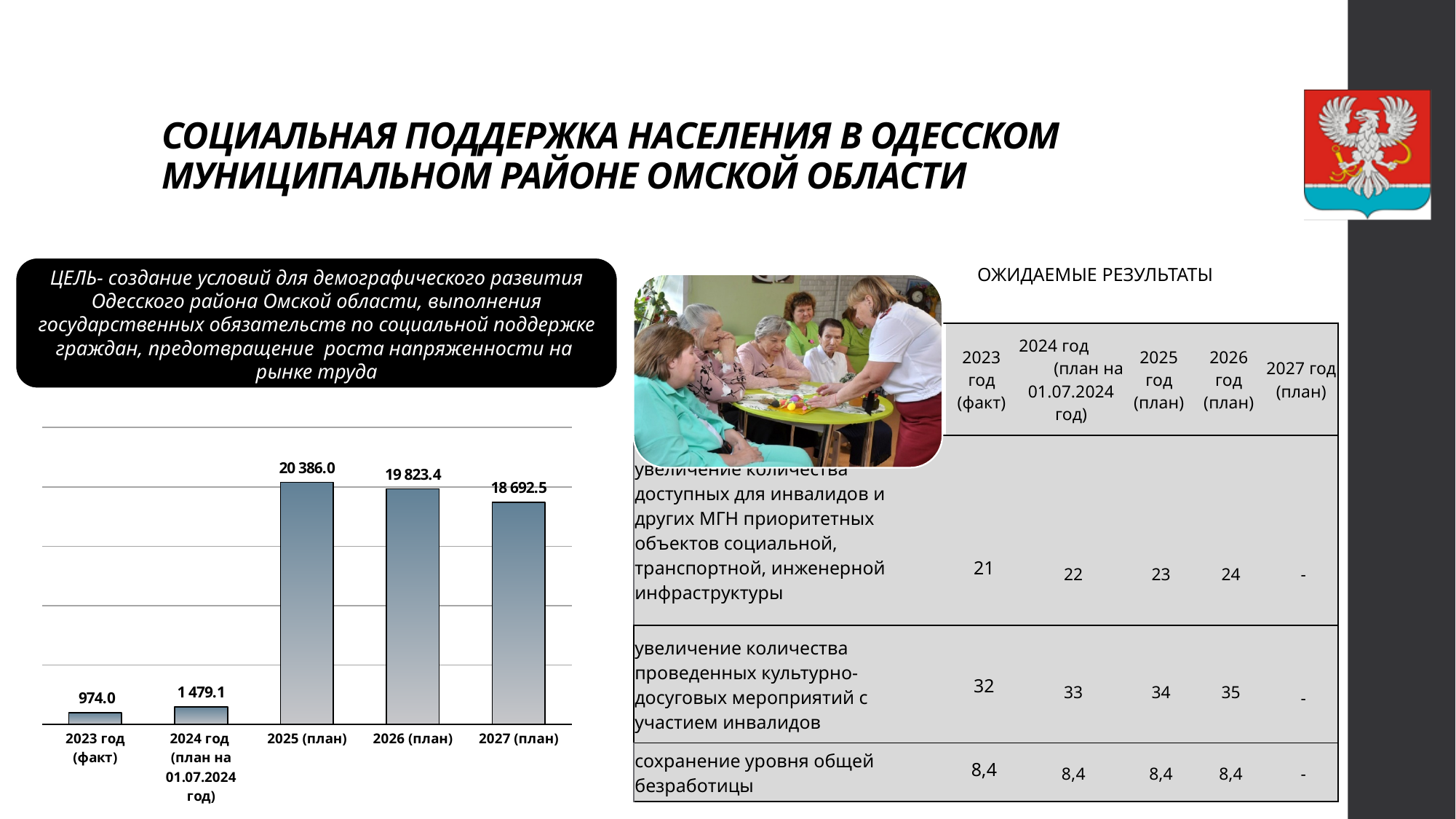
Which category has the lowest value in the bar chart? 2023 год (факт) How many categories are shown in the bar chart? 5 What kind of chart is shown on the slide? Bar chart What is the difference between the values for 2024 год (план на 01.07.2024 год) and 2023 год (факт)? 505.1 Which is larger, the value for 2026 (план) or the value for 2027 (план)? 2026 (план) What is the value for 2023 год (факт) in the bar chart? 974.0 What is the difference between the values for 2025 (план) and 2026 (план)? 562.6 What is the value for 2024 год (план на 01.07.2024 год) in the bar chart? 1 479.1 What is the value for 2025 (план) in the bar chart? 20 386.0 What is the value for 2027 (план) in the bar chart? 18 692.5 Which category has the highest value in the bar chart? 2025 (план) Do the values in the bar chart rise or fall from 2025 (план) to 2027 (план)? Fall